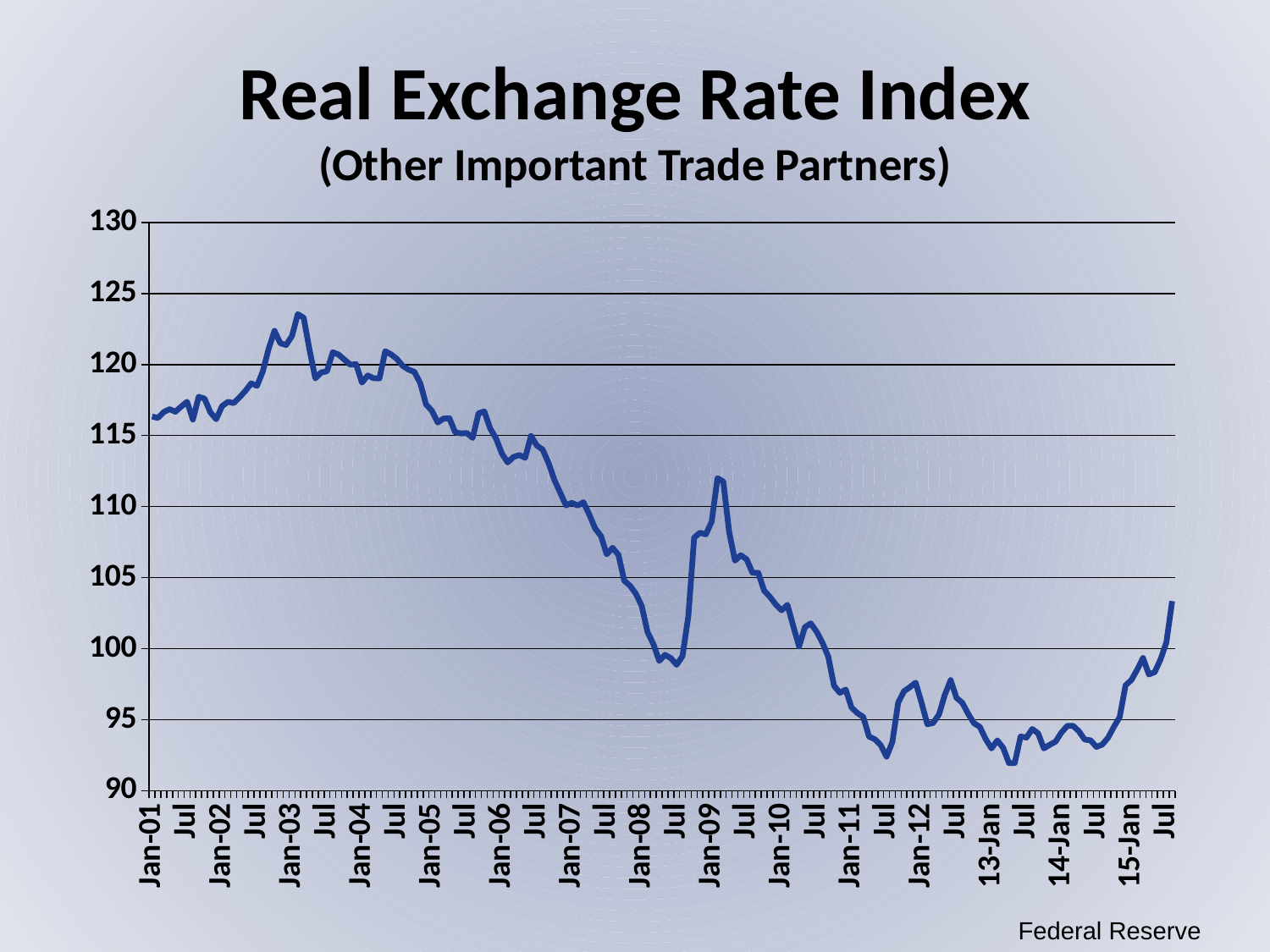
What source is cited for the chart data? Federal Reserve Is the value for Jan-11 greater or less than 100? less Is the value for Jan-05 greater or less than 115? greater In which year does the index reach its highest point? 2003 What is the title of the chart? Real Exchange Rate Index Is the value for Jan-01 greater or less than 115? greater Does the index rise or fall from 15-Jan to Jul 2015? rise Does the index generally rise or fall from Jan-01 to 13-Jan? fall What kind of chart is shown on the slide? line chart